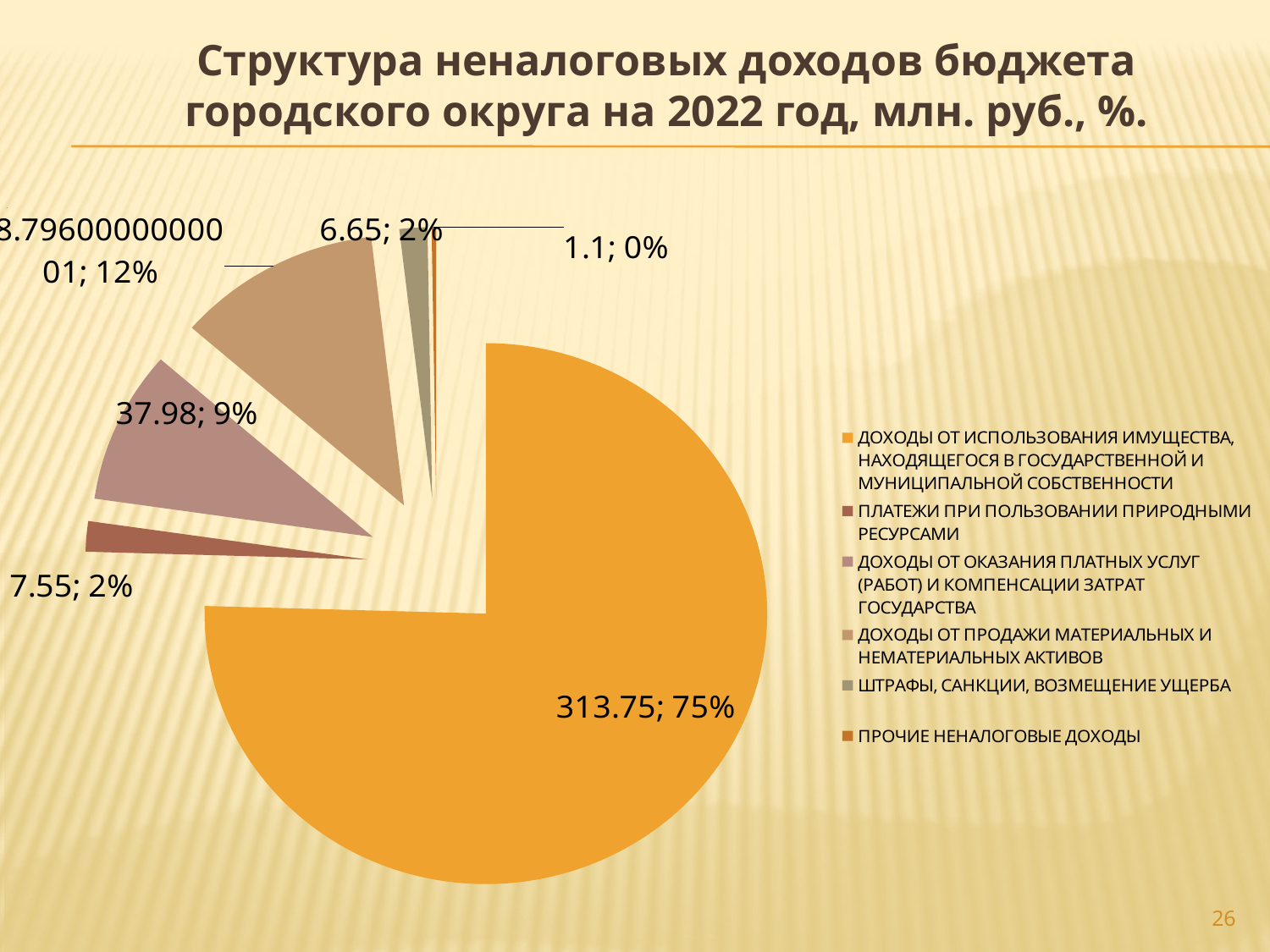
What value is shown for ШТРАФЫ, САНКЦИИ, ВОЗМЕЩЕНИЕ УЩЕРБА? 6.65 Which category has the smallest slice of the pie? ПРОЧИЕ НЕНАЛОГОВЫЕ ДОХОДЫ How many slices does the pie chart have? 6 How many entries does the legend list? 6 What share of the pie does ДОХОДЫ ОТ ИСПОЛЬЗОВАНИЯ ИМУЩЕСТВА, НАХОДЯЩЕГОСЯ В ГОСУДАРСТВЕННОЙ И МУНИЦИПАЛЬНОЙ СОБСТВЕННОСТИ take? 75% What share of the pie does ДОХОДЫ ОТ ПРОДАЖИ МАТЕРИАЛЬНЫХ И НЕМАТЕРИАЛЬНЫХ АКТИВОВ take? 12% What kind of chart is shown on the slide? pie chart What value is shown for ПЛАТЕЖИ ПРИ ПОЛЬЗОВАНИИ ПРИРОДНЫМИ РЕСУРСАМИ? 7.55 What is the difference between the values for ДОХОДЫ ОТ ОКАЗАНИЯ ПЛАТНЫХ УСЛУГ (РАБОТ) И КОМПЕНСАЦИИ ЗАТРАТ ГОСУДАРСТВА and ПЛАТЕЖИ ПРИ ПОЛЬЗОВАНИИ ПРИРОДНЫМИ РЕСУРСАМИ? 30.43 What value is shown for ПРОЧИЕ НЕНАЛОГОВЫЕ ДОХОДЫ? 1.1 What value is shown for ДОХОДЫ ОТ ОКАЗАНИЯ ПЛАТНЫХ УСЛУГ (РАБОТ) И КОМПЕНСАЦИИ ЗАТРАТ ГОСУДАРСТВА? 37.98 What value is shown for ДОХОДЫ ОТ ИСПОЛЬЗОВАНИЯ ИМУЩЕСТВА, НАХОДЯЩЕГОСЯ В ГОСУДАРСТВЕННОЙ И МУНИЦИПАЛЬНОЙ СОБСТВЕННОСТИ? 313.75